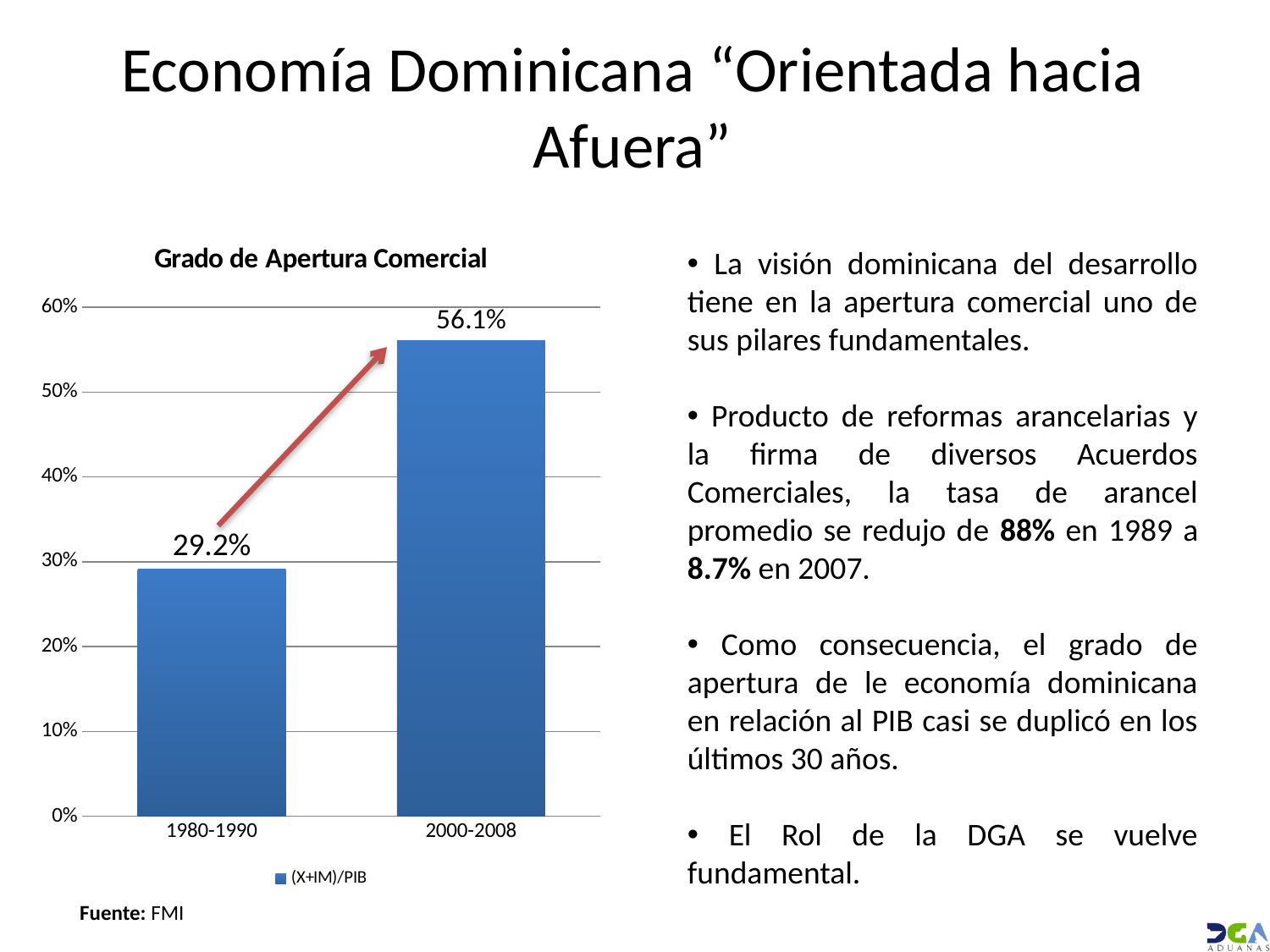
What is the legend entry of the series in the chart? (X+IM)/PIB How many periods are shown on the x axis of the chart? 2 What is the value for 2000-2008 in the Grado de Apertura Comercial chart? 56.1% What is the difference between the values for 2000-2008 and 1980-1990? 26.9% Is the value for 1980-1990 greater or less than 30%? less Which period has the lowest value in the Grado de Apertura Comercial chart? 1980-1990 What kind of chart is shown on the slide? bar chart What is the value for 1980-1990 in the Grado de Apertura Comercial chart? 29.2% Which period has the highest value in the Grado de Apertura Comercial chart? 2000-2008 Is the value for 2000-2008 greater or less than 50%? greater Which is larger, the value for 1980-1990 or the value for 2000-2008? 2000-2008 How many series does the chart legend list? 1